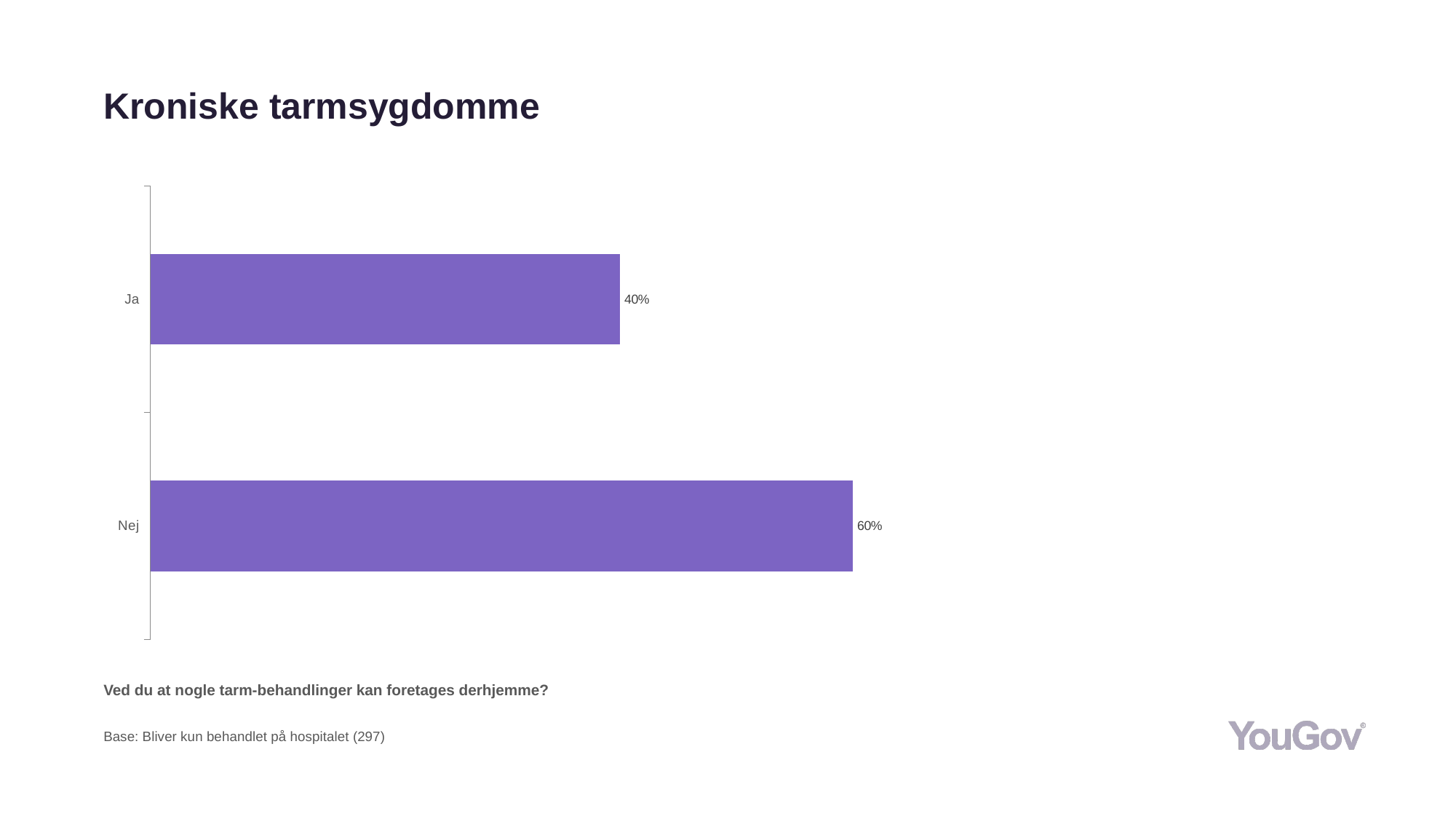
Which category has the lowest value? Ja How many categories are shown in the chart? 2 Which category has the highest value? Nej What is the total of the values for "Ja" and "Nej"? 100% What is the value for "Ja"? 40% What is the difference between the values for "Nej" and "Ja"? 20% What is the base size stated below the chart? 297 What kind of chart is shown on the slide? Bar chart Which is larger, the value for "Ja" or the value for "Nej"? Nej What is the title of the slide? Kroniske tarmsygdomme What is the value for "Nej"? 60%